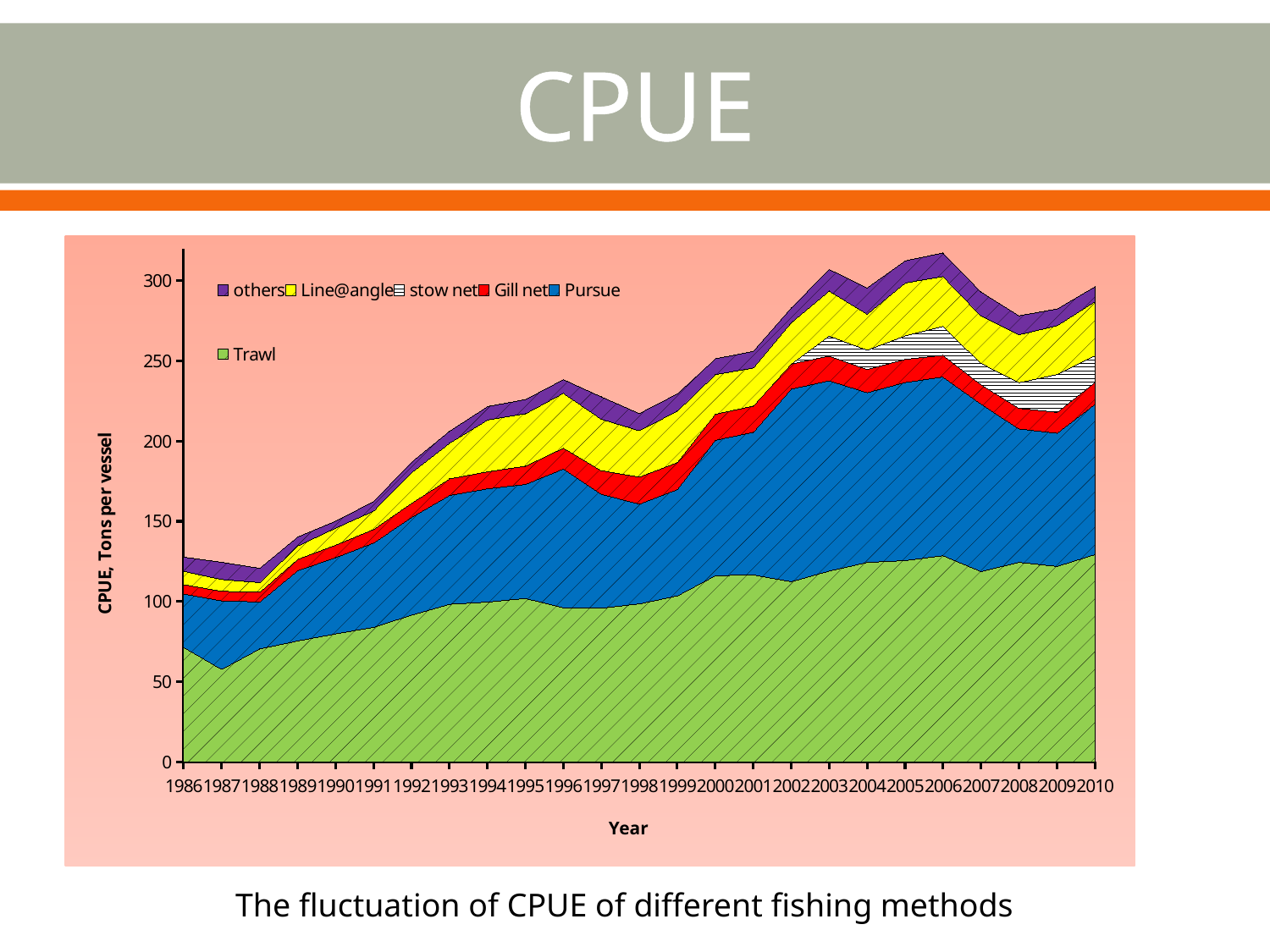
Is the Trawl value in 2010 greater or less than 100? greater How many series does the legend list? 6 Is the total CPUE across all methods in 1986 greater or less than 150? less What kind of chart is shown on the slide? stacked area chart Is the Trawl value in 1986 greater or less than 100? less How many years are shown along the x axis? 25 Which series is plotted as the bottom (green) layer of the chart? Trawl What is the label of the y axis? CPUE, Tons per vessel Which is larger, the total CPUE in 2006 or in 1986? 2006 Does the total CPUE across all methods generally rise or fall from 1986 to 2010? rise